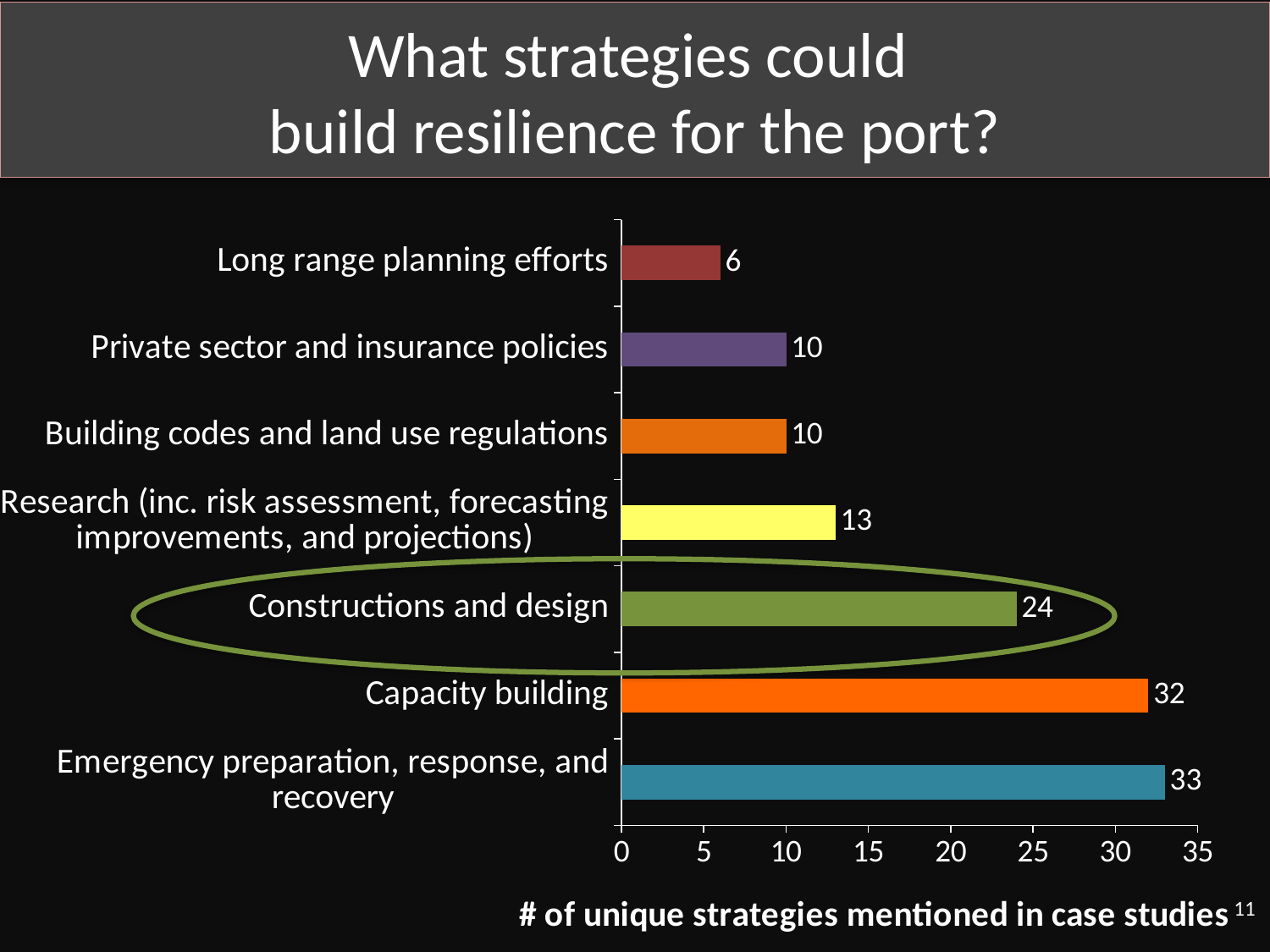
Is the value for Capacity building greater or less than 30? greater What is the value for Research (inc. risk assessment, forecasting improvements, and projections)? 13 Which category has the highest value? Emergency preparation, response, and recovery Which category is circled on the slide? Constructions and design What kind of chart is shown on the slide? bar chart What is the value for Long range planning efforts? 6 What is the label of the horizontal axis? # of unique strategies mentioned in case studies Which category has the lowest value? Long range planning efforts What is the difference between the values for Capacity building and Constructions and design? 8 Which is larger, the value for Research (inc. risk assessment, forecasting improvements, and projections) or the value for Building codes and land use regulations? Research (inc. risk assessment, forecasting improvements, and projections) What is the value for Constructions and design? 24 How many categories are shown in the chart? 7